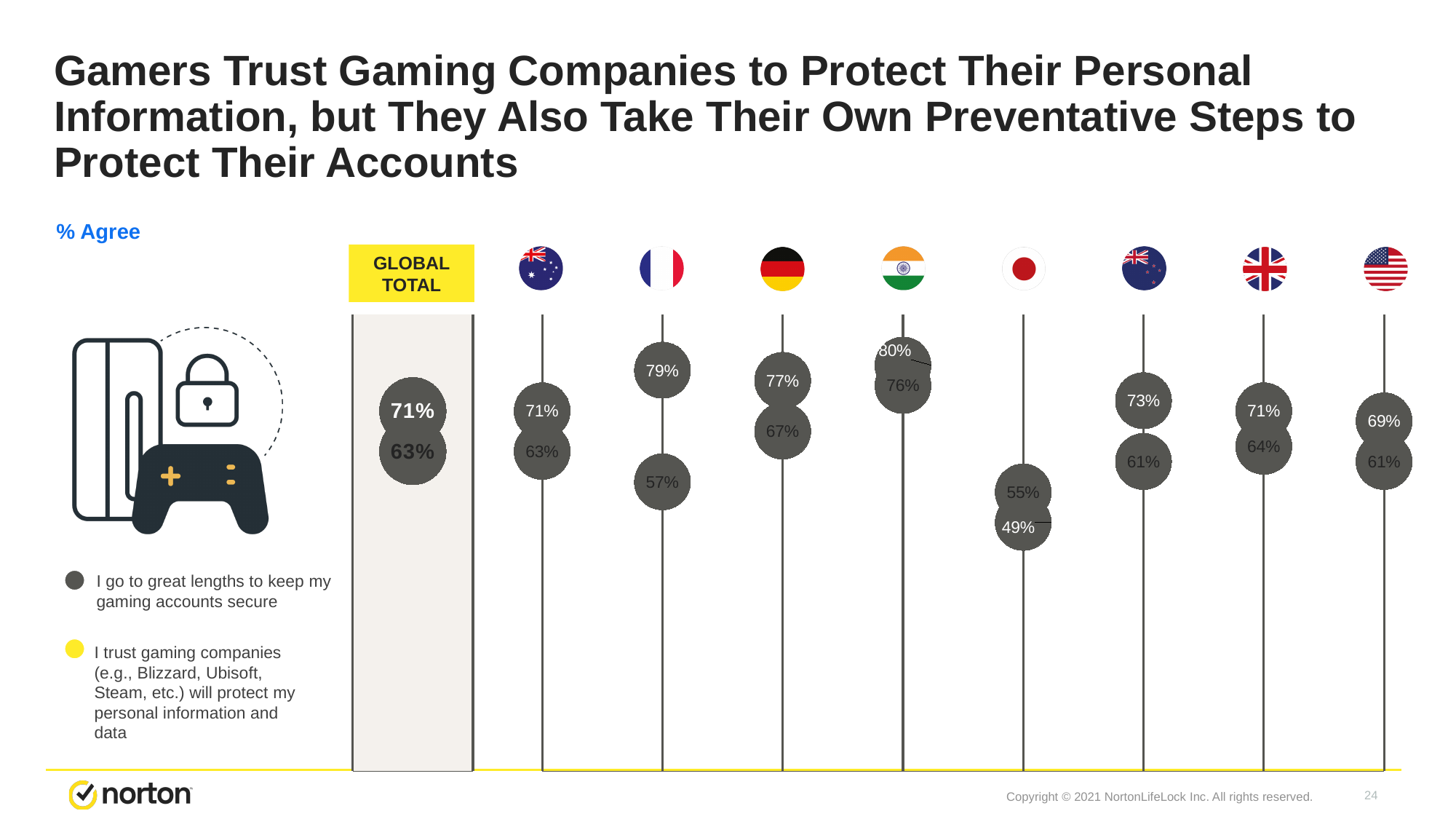
What is the difference between the two values shown for France (79% and 57%)? 22 percentage points How many columns (Global Total plus countries) are plotted on the chart? 9 What is the higher of the two values shown for the Global Total? 71% What are the two values shown for Japan (the column with the Japanese flag)? 55% and 49% What unit of measure is indicated above the chart? % Agree What is the higher of the two values shown for France (the column with the French flag)? 79% What is the difference between the two values shown for the Global Total? 8 percentage points What is the lower of the two values shown for the Global Total? 63% Is the higher value for Germany (77%) larger or smaller than the higher value for the United States (69%)? larger How many series does the legend list? 2 Which country column shows the lowest value on the chart? Japan (49%) Which country column shows the highest value on the chart? India (80%)